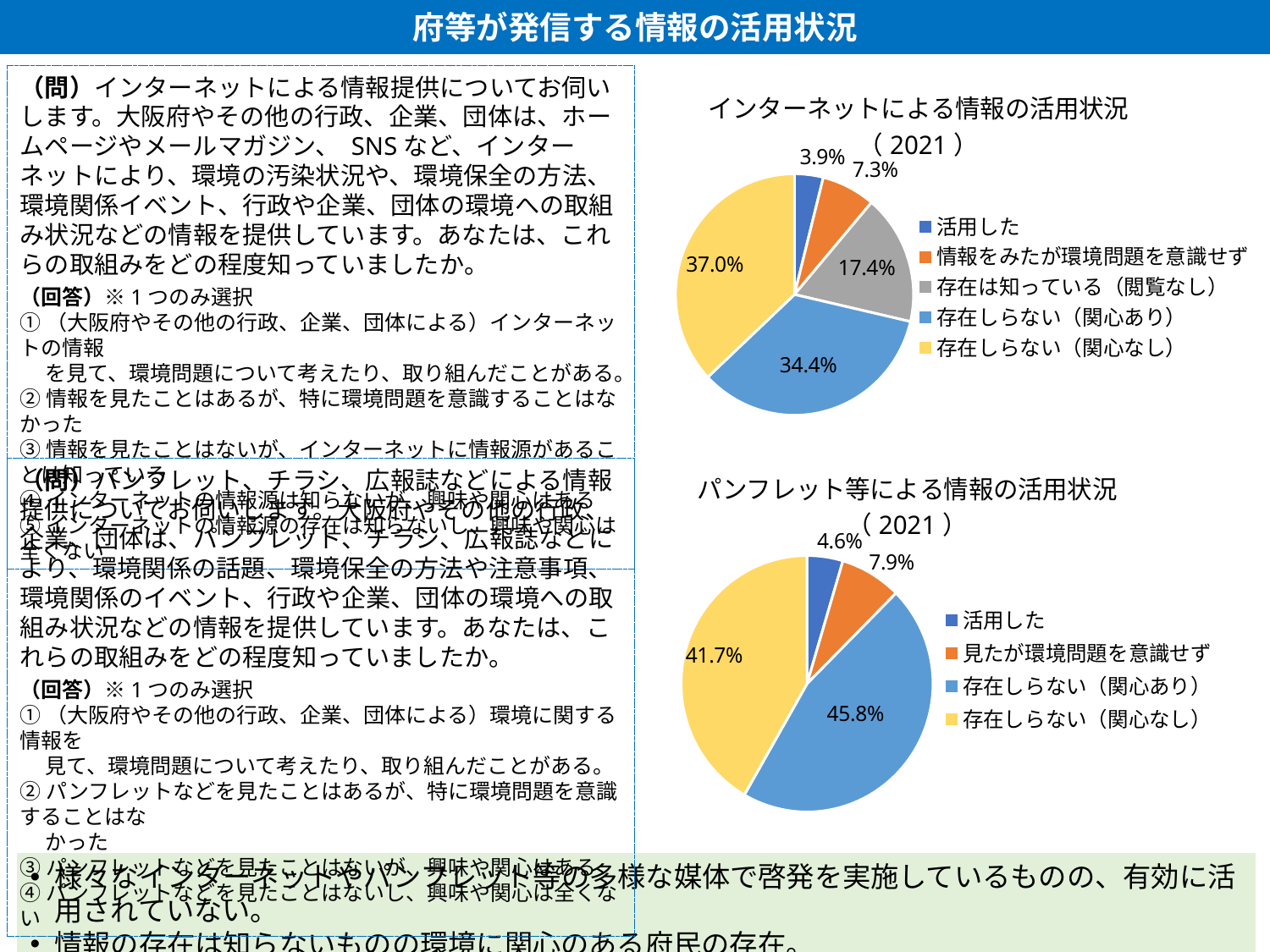
In the top pie chart (インターネットによる情報の活用状況), what is the value for 活用した? 3.9% In the bottom pie chart (パンフレット等による情報の活用状況), which is larger: 活用した or 見たが環境問題を意識せず? 見たが環境問題を意識せず In the bottom pie chart (パンフレット等による情報の活用状況), what is the value for 見たが環境問題を意識せず? 7.9% In the bottom pie chart (パンフレット等による情報の活用状況), which category has the largest share? 存在しらない（関心あり） In the top pie chart (インターネットによる情報の活用状況), what is the difference between 存在しらない（関心なし） and 存在しらない（関心あり）? 2.6% How many categories does the legend of the bottom pie chart (パンフレット等による情報の活用状況) list? 4 How many categories does the legend of the top pie chart (インターネットによる情報の活用状況) list? 5 In the top pie chart (インターネットによる情報の活用状況), what is the value for 存在は知っている（閲覧なし）? 17.4% In the top pie chart (インターネットによる情報の活用状況), which category has the smallest share? 活用した In the top pie chart (インターネットによる情報の活用状況), which category has the largest share? 存在しらない（関心なし） In the bottom pie chart (パンフレット等による情報の活用状況), what is the value for 存在しらない（関心あり）? 45.8% What type of chart is the bottom chart (パンフレット等による情報の活用状況)? Pie chart